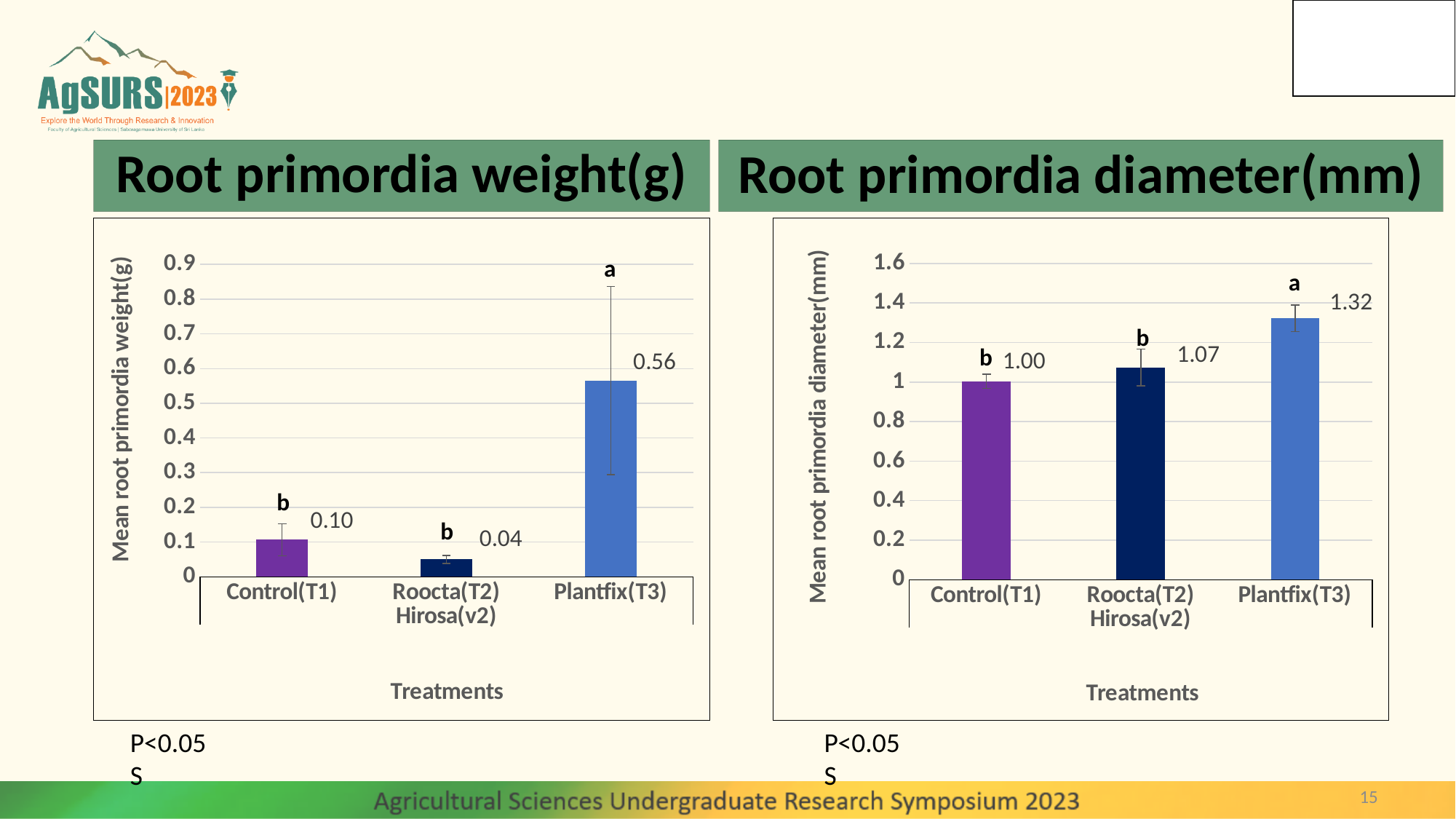
In the Root primordia diameter(mm) chart, is the value for Plantfix(T3) greater or less than 1.2? greater In the Root primordia weight(g) chart, what is the value for Roocta(T2) Hirosa(v2)? 0.04 In the Root primordia weight(g) chart, what is the value for Plantfix(T3)? 0.56 In the Root primordia weight(g) chart, what is the difference between the values for Plantfix(T3) and Control(T1)? 0.46 In the Root primordia diameter(mm) chart, what is the difference between the values for Plantfix(T3) and Roocta(T2) Hirosa(v2)? 0.25 In the Root primordia weight(g) chart, which treatment has the highest mean root primordia weight? Plantfix(T3) In the Root primordia diameter(mm) chart, what is the value for Plantfix(T3)? 1.32 In the Root primordia weight(g) chart, which treatment has the lowest mean root primordia weight? Roocta(T2) Hirosa(v2) How many treatments are shown in the Root primordia weight(g) chart? 3 In the Root primordia diameter(mm) chart, what is the value for Control(T1)? 1.00 What kind of chart is the Root primordia diameter(mm) chart? Bar chart In the Root primordia diameter(mm) chart, which treatment has the highest mean root primordia diameter? Plantfix(T3)